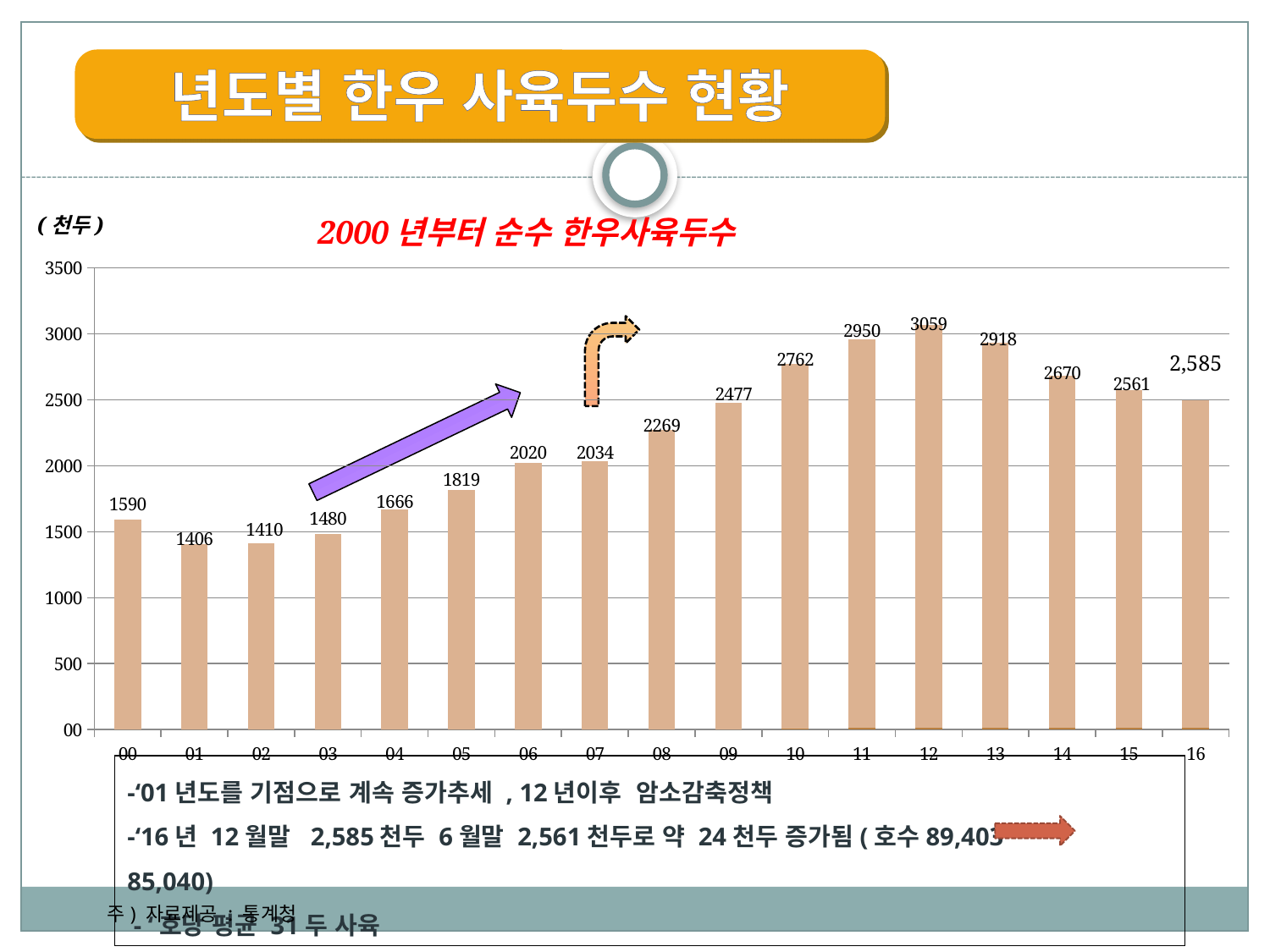
What is the value for year 00? 1590 How many years are shown on the x axis? 17 Which year has the lowest value? 01 Is the value for year 13 greater or less than 2500? greater Which year has the highest value? 12 Do the values rise or fall from year 01 to year 12? rise What is the value for year 08? 2269 What is the value for year 12? 3059 What kind of chart is shown on the slide? bar chart Which is larger, the value for year 05 or the value for year 04? 05 What is the difference between the values for year 12 and year 11? 109 What is the difference between the values for year 10 and year 09? 285